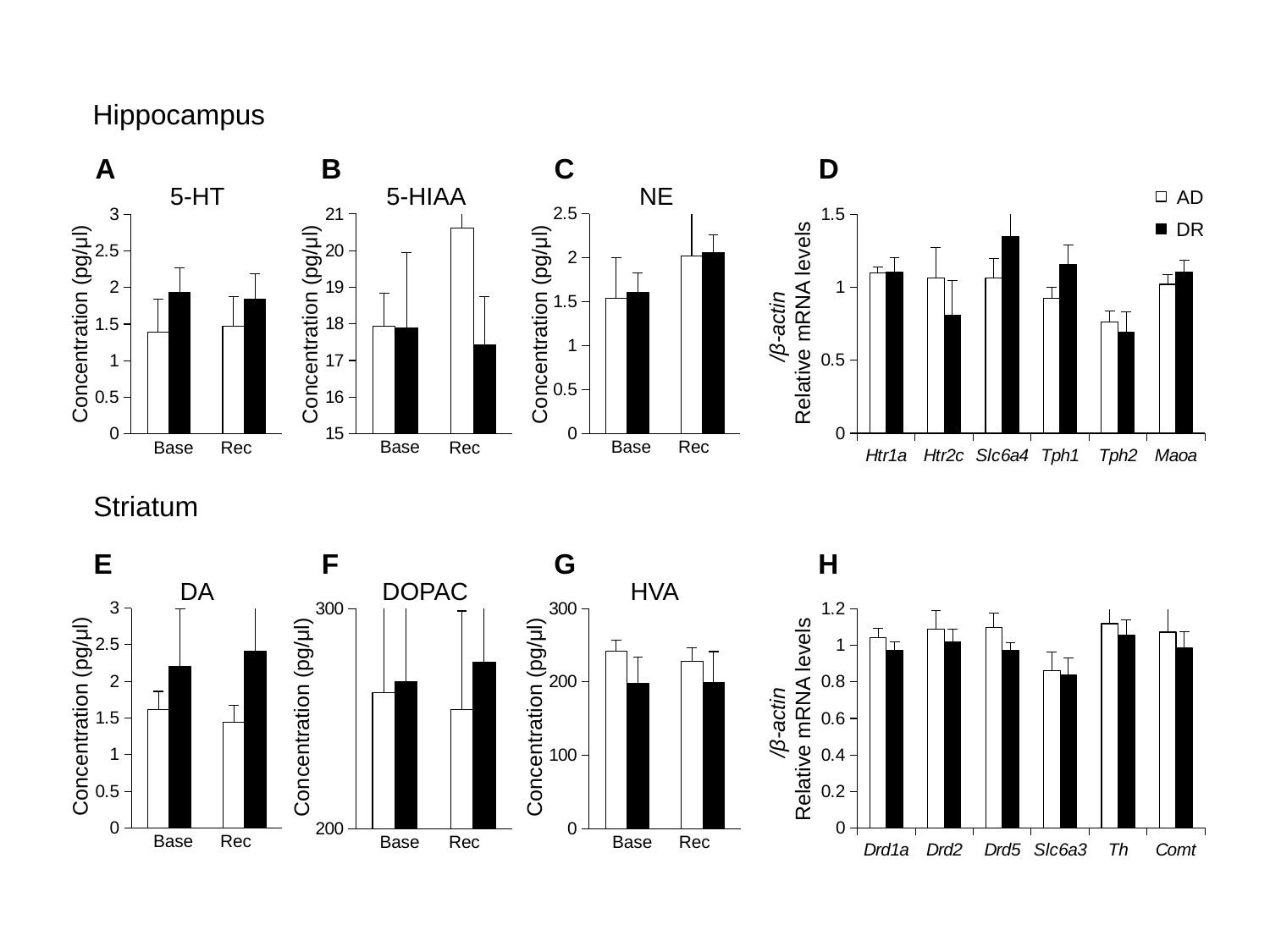
In chart D (hippocampus mRNA levels), which gene has the lowest AD bar? Tph2 In chart B (5-HIAA), which is larger at Rec, the AD bar or the DR bar? AD In chart A (5-HT), is the DR value at Base greater or less than 1.5? greater How many genes are shown on the x axis of chart H? 6 What kind of chart is chart C (NE)? bar chart How many series does the legend in chart D list? 2 In chart G (HVA), is the AD value at Base greater or less than 200? greater In chart G (HVA), which is larger at Base, the AD bar or the DR bar? AD In chart D (hippocampus mRNA levels), which gene has the highest DR bar? Slc6a4 In chart B (5-HIAA), is the AD value at Rec greater or less than 20? greater In chart H (striatum mRNA levels), which gene has the lowest AD bar? Slc6a3